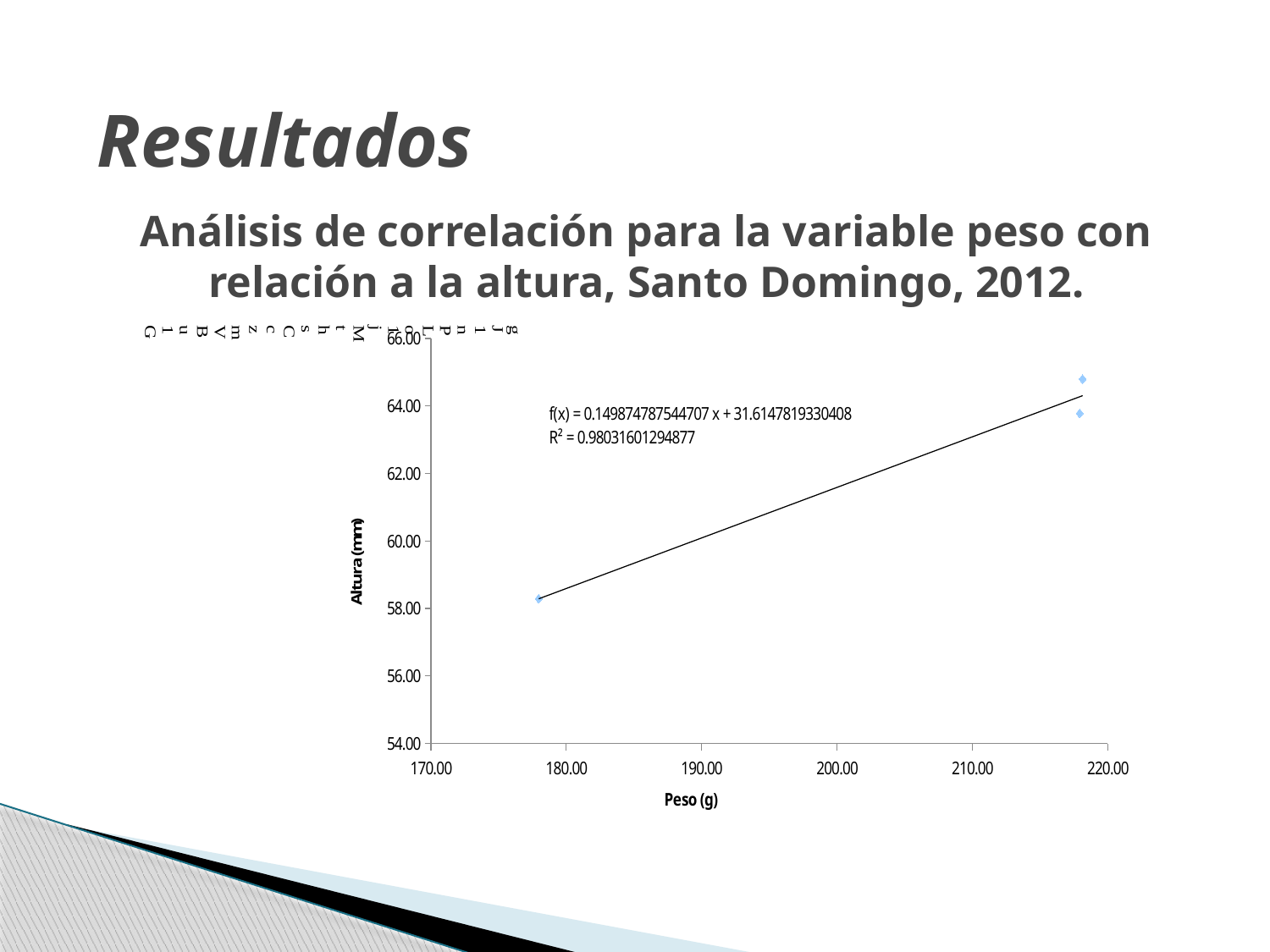
Is the altura of the highest data point greater or less than 64.00? greater Is the altura of the data point with the lowest peso greater or less than 60.00? less How many data points are plotted on the chart? 3 Is the peso of the data points on the right side of the chart greater or less than 210.00? greater What is the label of the x axis of the chart? Peso (g) Does the altura rise or fall as peso increases along the x axis? rise What is the label of the y axis of the chart? Altura (mm) What R² value is printed on the chart? 0.98031601294877 What kind of chart is shown on the slide? scatter chart What is the trendline equation printed on the chart? f(x) = 0.149874787544707 x + 31.6147819330408 What is the maximum value shown on the x axis of the chart? 220.00